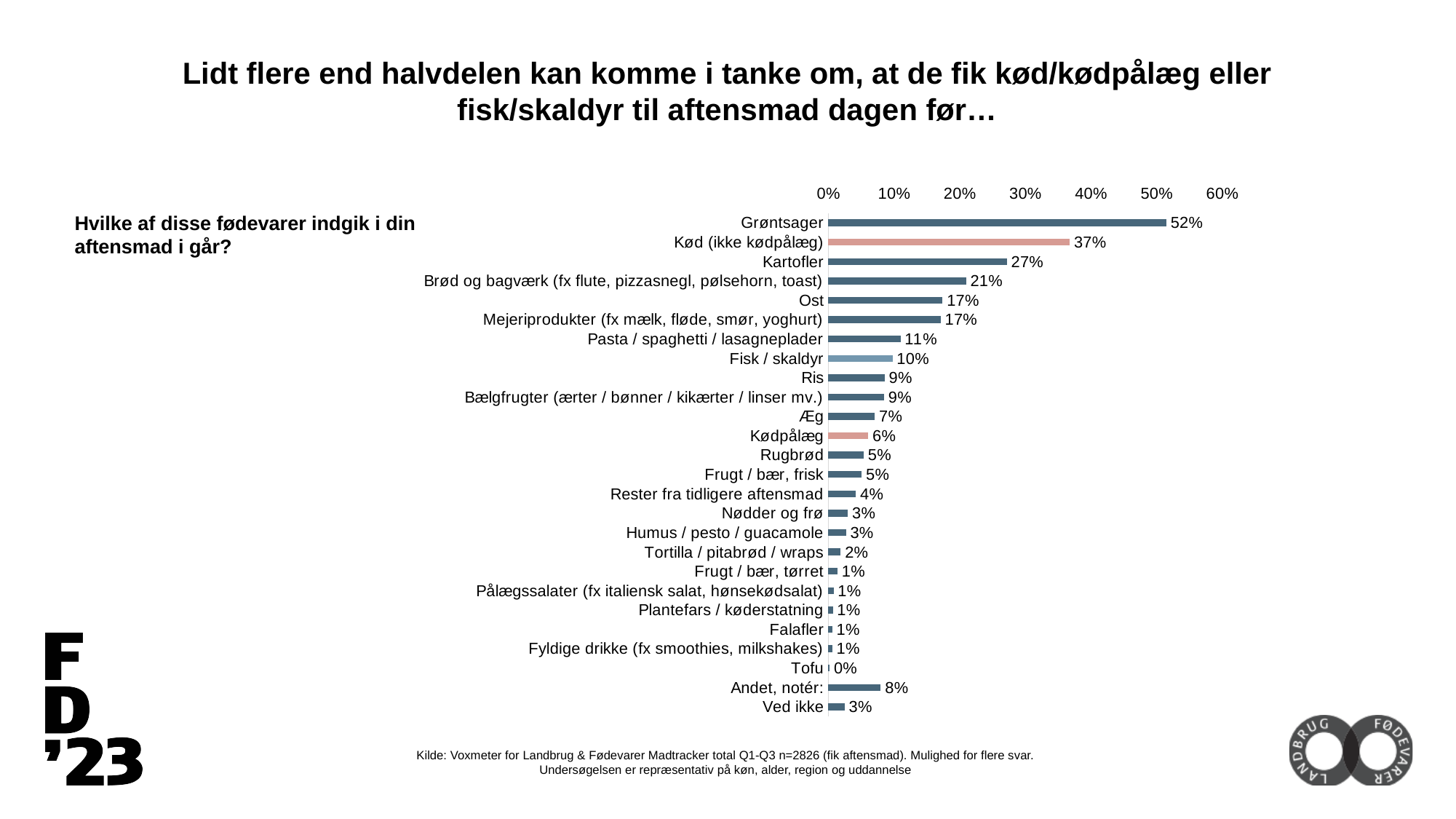
What kind of chart is shown on the slide? Bar chart What is the difference between the values for Grøntsager and Kød (ikke kødpålæg)? 15% What is the value for Grøntsager? 52% Which category has the lowest value? Tofu What is the value for Kød (ikke kødpålæg)? 37% Is the value for Kød (ikke kødpålæg) greater or less than 30%? greater Which category has the highest value? Grøntsager Which is larger, the value for Kartofler or the value for Brød og bagværk (fx flute, pizzasnegl, pølsehorn, toast)? Kartofler What is the value for Kødpålæg? 6% What is the value for Andet, notér:? 8% What is the value for Fisk / skaldyr? 10% How many categories are shown in the chart? 26